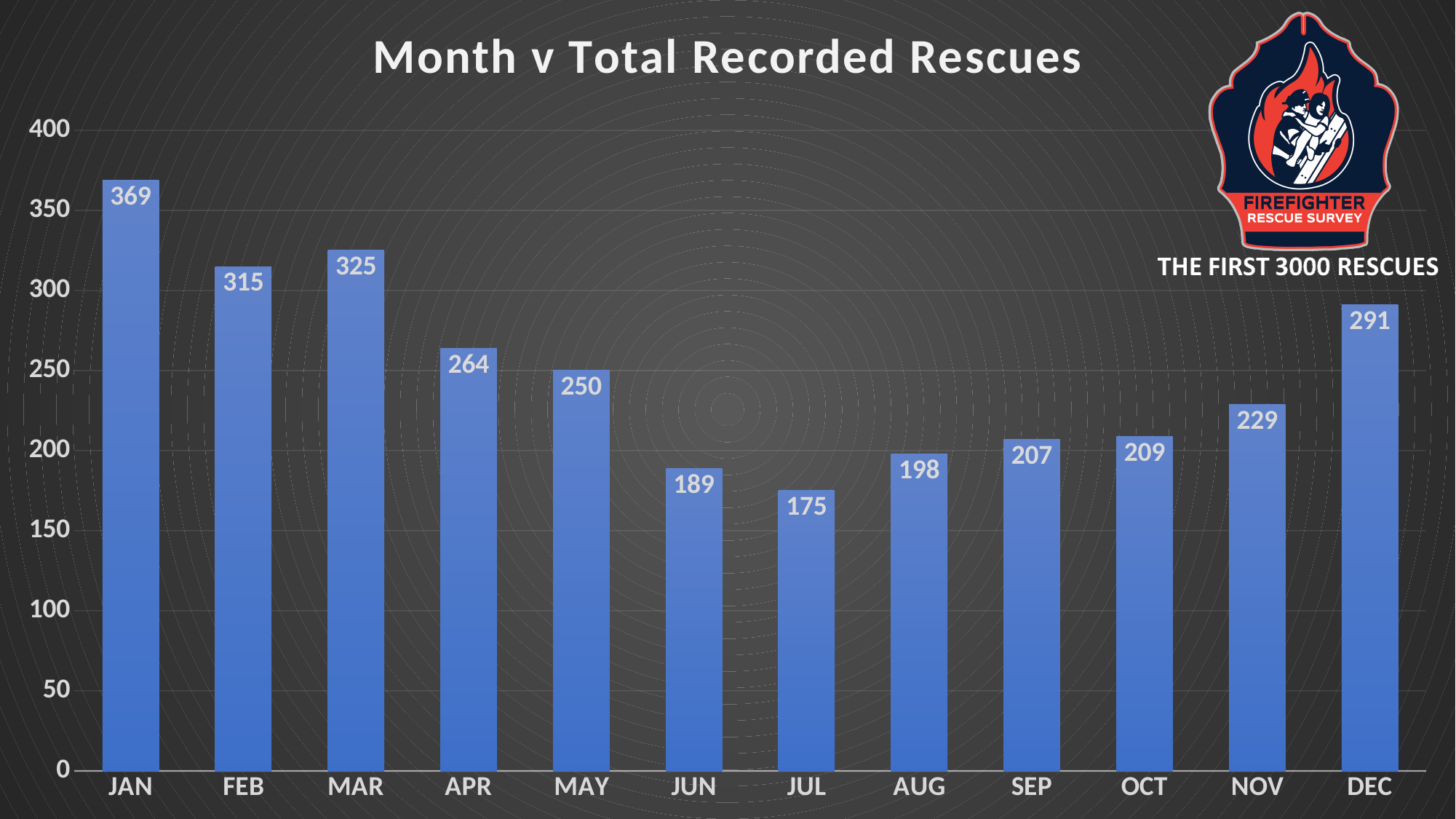
Which month has the lowest total recorded rescues? JUL What is the total recorded rescues value for JUL? 175 What is the difference between the values for JAN and JUL? 194 What is the difference between the values for MAR and FEB? 10 How many months are shown on the x axis? 12 Is the value for NOV greater or less than 200? greater What is the total recorded rescues value for JAN? 369 What kind of chart is shown on the slide? Bar chart Which has a larger value, APR or MAY? APR Which month has the highest total recorded rescues? JAN What is the total recorded rescues value for DEC? 291 What is the title of the chart? Month v Total Recorded Rescues